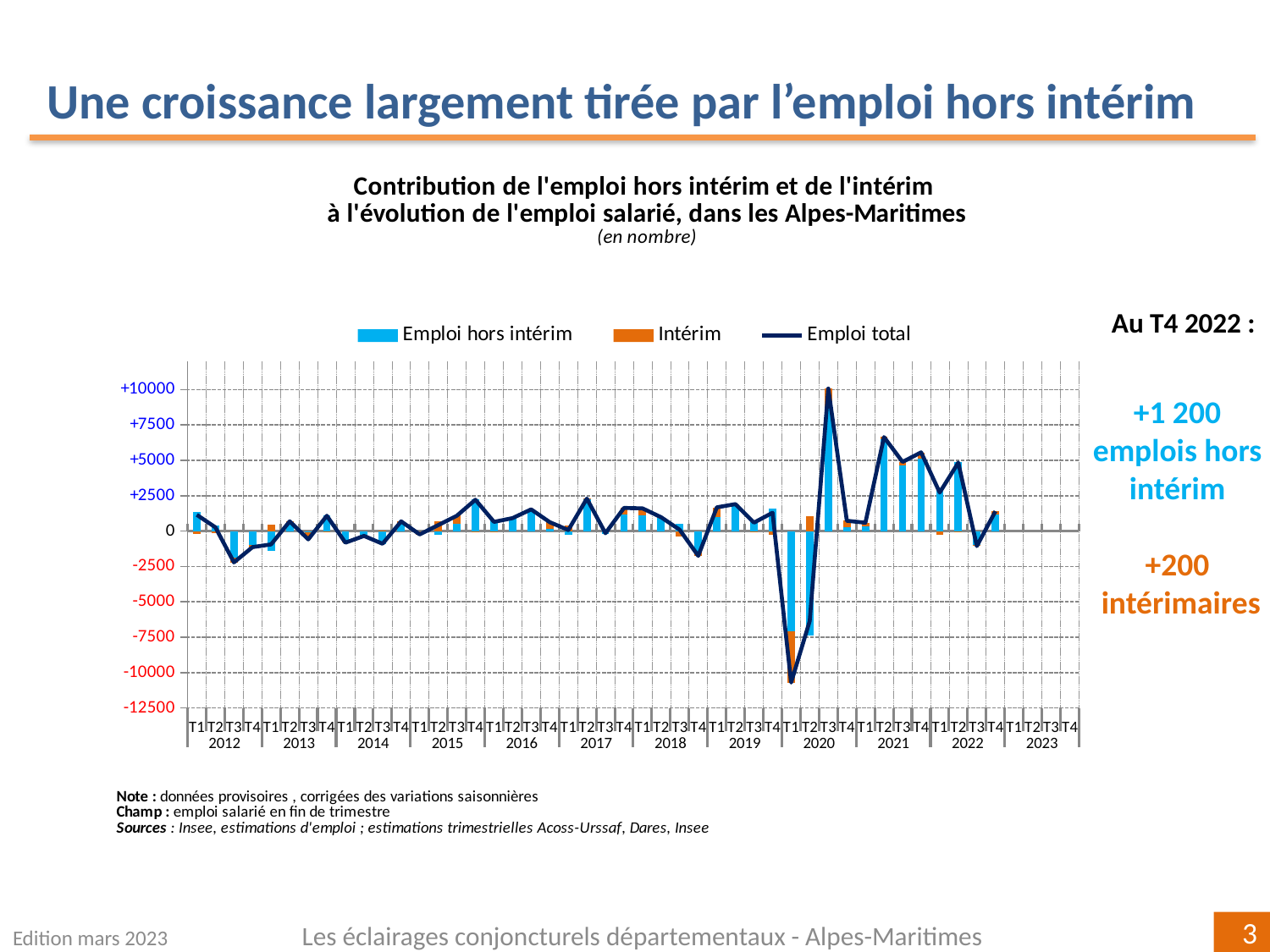
Does the Emploi total line rise or fall between T1 2020 and T3 2020? rise Is the value for Emploi total at T1 2020 greater or less than -10000? less Which is larger for Emploi hors intérim: the bar at T3 2020 or the bar at T2 2021? T3 2020 According to the slide, what is the value for Emploi hors intérim at T4 2022? +1 200 Is the value for Emploi total at T3 2020 greater or less than +7500? greater Which series is drawn as a line rather than bars? Emploi total In which quarter does the Emploi total line reach its lowest point? T1 2020 Is the value for Emploi hors intérim at T1 2020 greater or less than -5000? less What kind of chart is shown on the slide? A combined bar and line chart How many series does the chart legend list? 3 In which quarter does the Emploi total line reach its highest point? T3 2020 According to the slide, what is the value for Intérim at T4 2022? +200